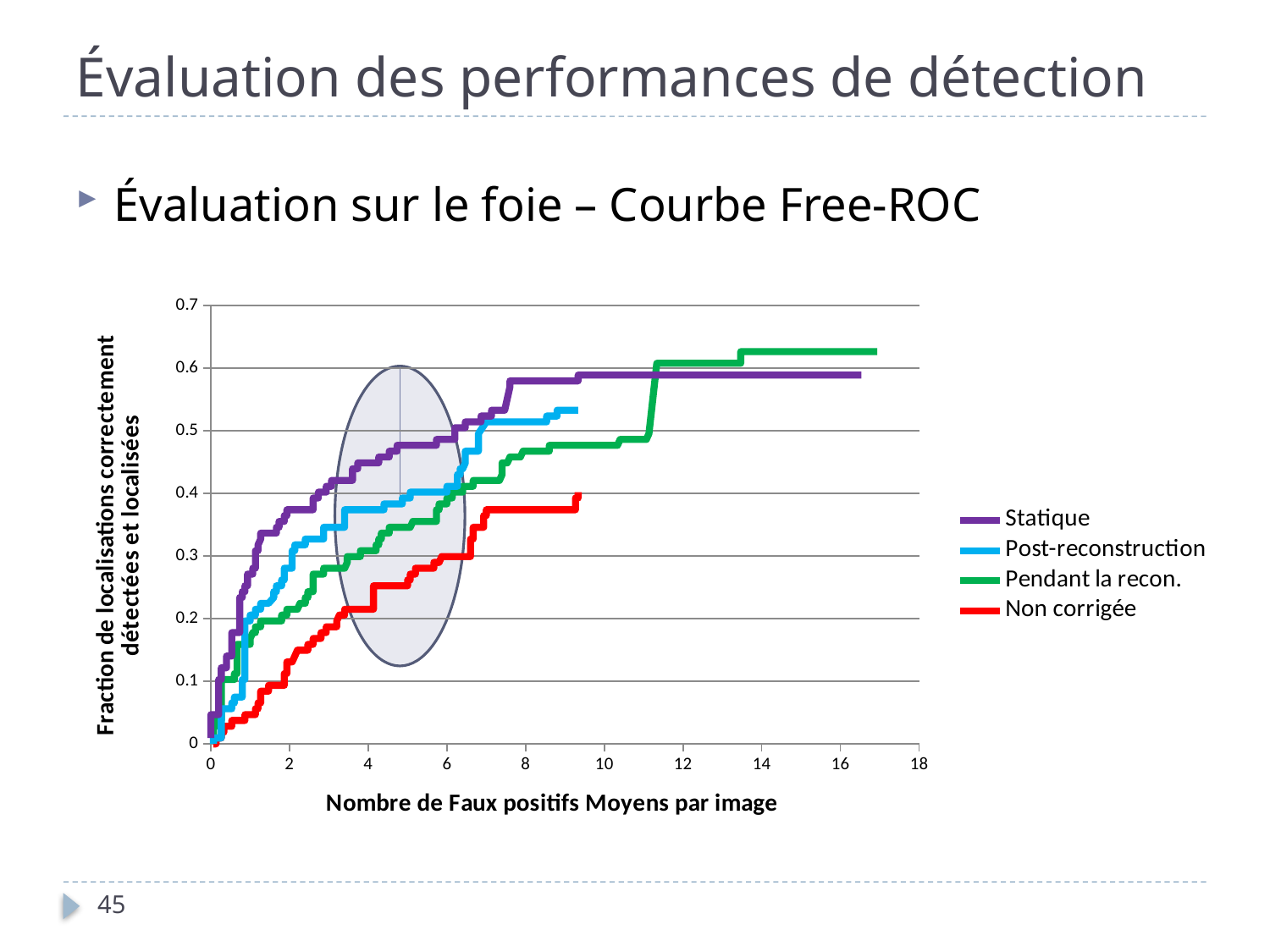
Which series reaches the highest fraction on the chart? Pendant la recon. Is the value for Statique at 4 false positives per image greater or less than 0.4? greater Which series is drawn in red in the legend? Non corrigée Is the value for Non corrigée at 4 false positives per image greater or less than 0.3? less How many series does the legend list? 4 At 4 false positives per image, which series has the larger value, Statique or Non corrigée? Statique At 14 false positives per image, which series has the larger value, Pendant la recon. or Statique? Pendant la recon. Do the values of the Statique series rise or fall as the number of false positives per image increases? rise Which series stays lowest across the chart? Non corrigée What is the title of the x axis? Nombre de Faux positifs Moyens par image Is the value for Pendant la recon. at 14 false positives per image greater or less than 0.6? greater What kind of chart is shown on the slide? line chart